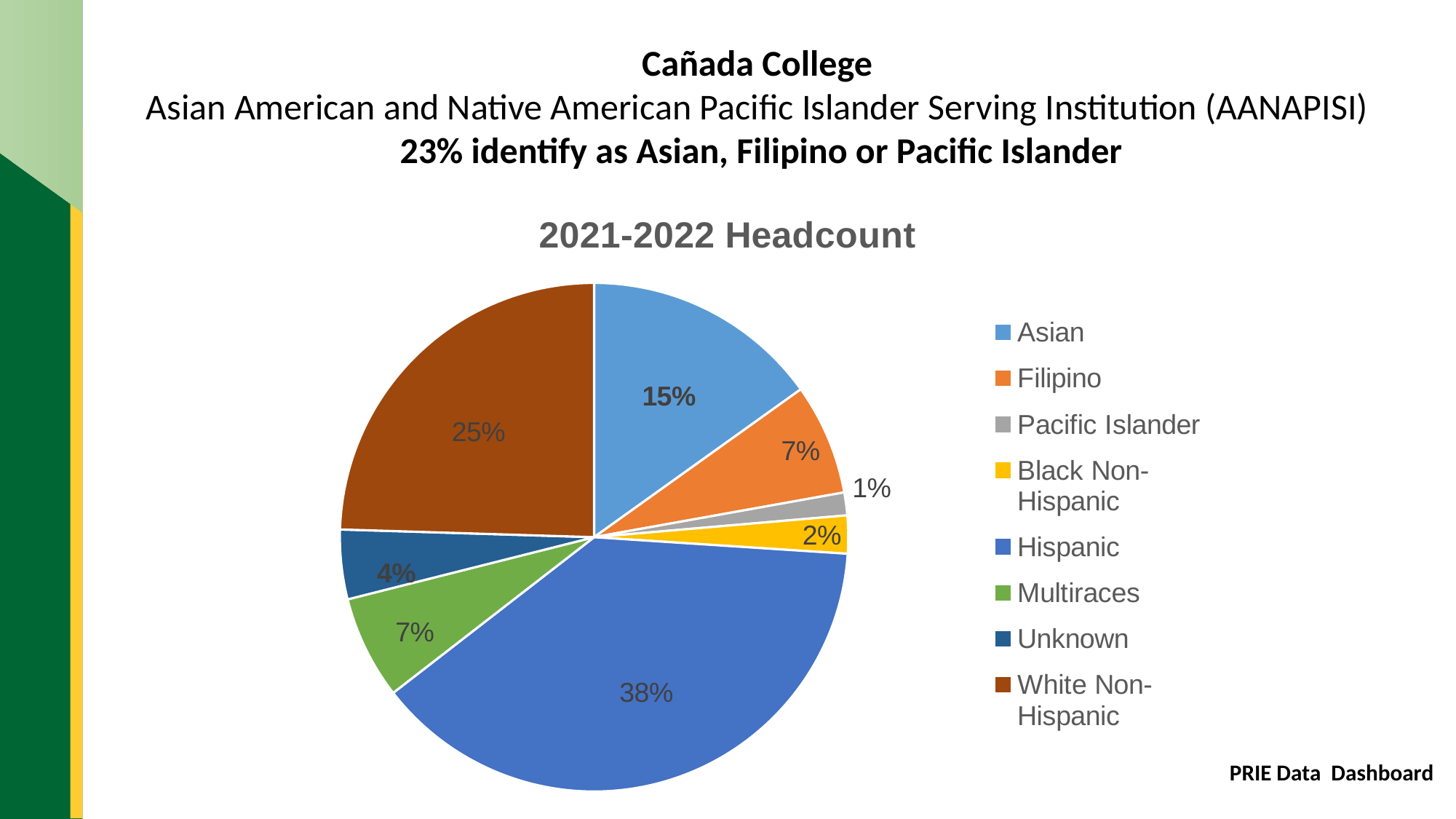
Which category has the largest slice of the pie? Hispanic What share of the 2021-2022 headcount is Black Non-Hispanic? 2% What is the difference between the Hispanic share and the White Non-Hispanic share? 13% What share of the 2021-2022 headcount is Asian? 15% What share of the 2021-2022 headcount is Pacific Islander? 1% What is the title of the chart? 2021-2022 Headcount What type of chart is shown on the slide? pie chart Which category has the smallest slice of the pie? Pacific Islander How many categories does the legend list? 8 Which is larger, the Asian share or the Unknown share? Asian